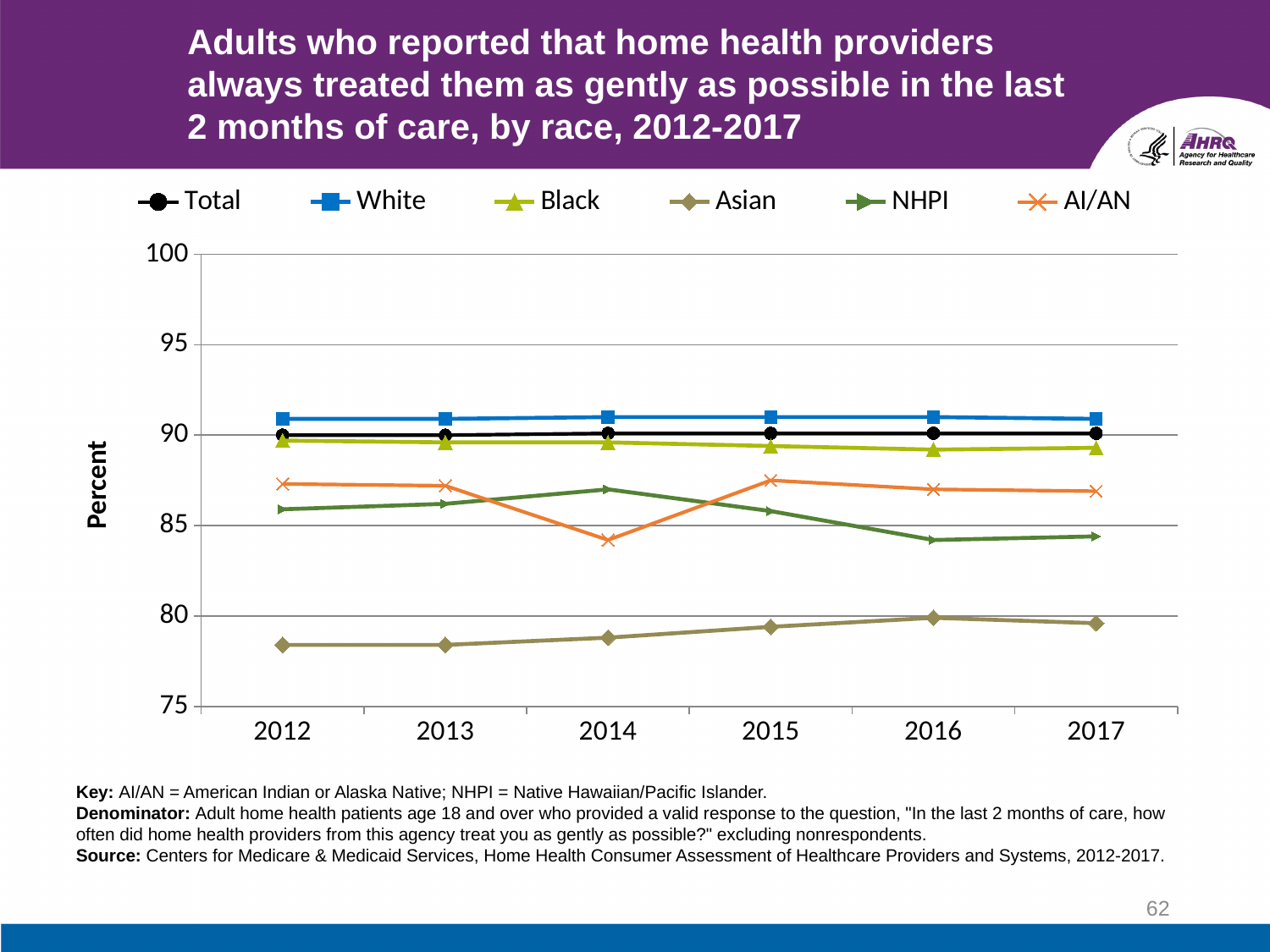
Is the value for Asian in 2012 greater or less than 80? less How many series does the legend list? 6 In 2014, which is larger, the value for NHPI or the value for AI/AN? NHPI How many years are shown along the x axis? 6 Which series has the highest value in 2017? White Does the Asian series rise or fall from 2012 to 2016? rise Is the value for AI/AN in 2014 greater or less than 85? less What kind of chart is shown on the slide? line chart Which series has the lowest value in 2012? Asian What is the label on the y axis? Percent Is the value for White in 2014 greater or less than 90? greater